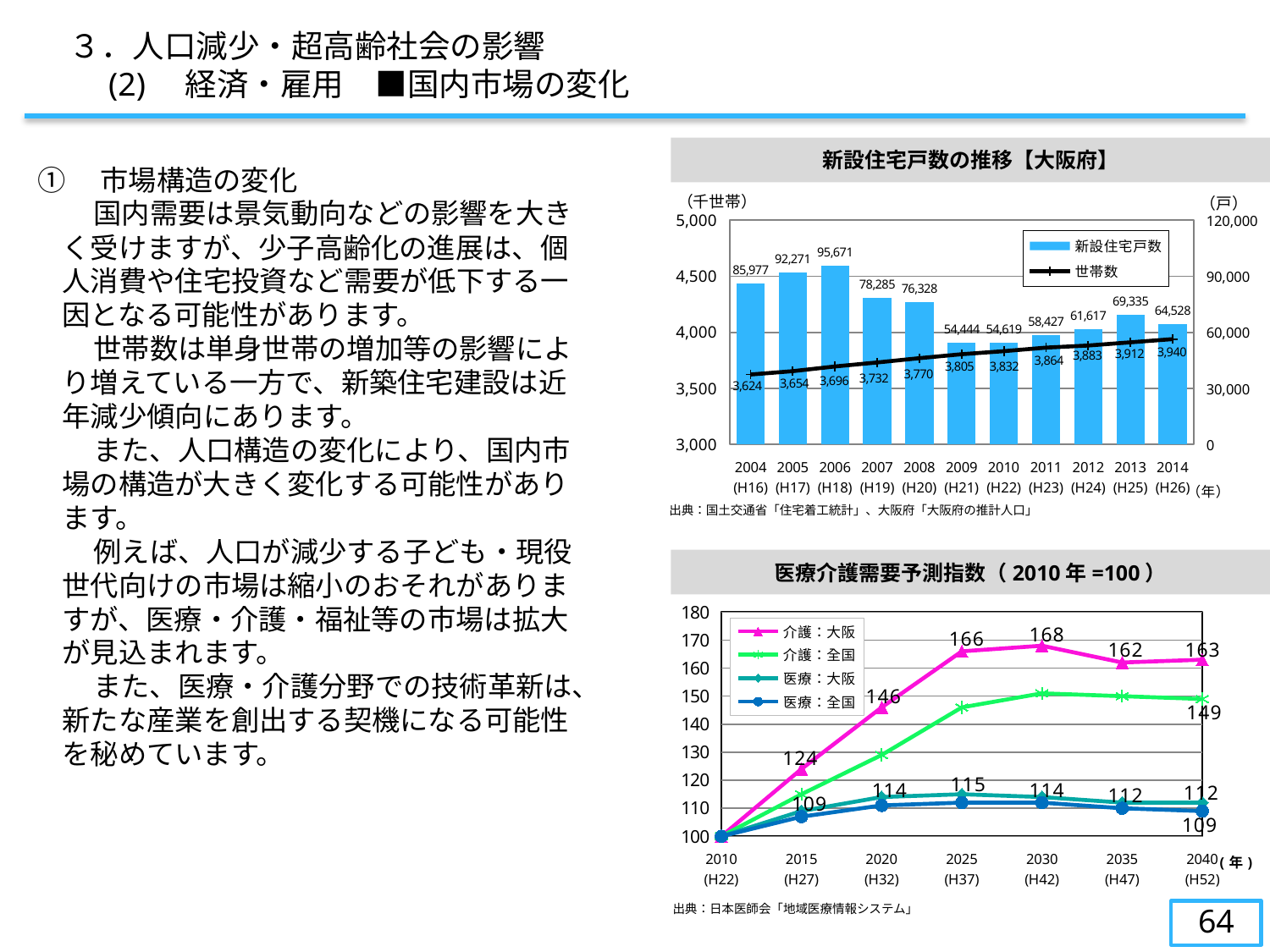
In the 新設住宅戸数の推移【大阪府】 chart, which year has the lowest 新設住宅戸数? 2009 In the 医療介護需要予測指数 chart, which is larger in 2040, 介護：大阪 or 介護：全国? 介護：大阪 In the 新設住宅戸数の推移【大阪府】 chart, what is the difference in 新設住宅戸数 between 2013 and 2014? 4,807 In the 新設住宅戸数の推移【大阪府】 chart, how many series does the legend list? 2 In the 新設住宅戸数の推移【大阪府】 chart, what is the value of 新設住宅戸数 for 2006? 95,671 In the 新設住宅戸数の推移【大阪府】 chart, which year has the highest 新設住宅戸数? 2006 In the 新設住宅戸数の推移【大阪府】 chart, does 世帯数 rise or fall from 2004 to 2014? rise In the 医療介護需要予測指数 chart, how many series does the legend list? 4 In the 医療介護需要予測指数 chart, what is the value of 介護：大阪 for 2030? 168 In the 新設住宅戸数の推移【大阪府】 chart, what is the value of 世帯数 for 2014? 3,940 In the 医療介護需要予測指数 chart, which year has the highest value for 介護：大阪? 2030 In the 新設住宅戸数の推移【大阪府】 chart, how many years are shown on the x axis? 11